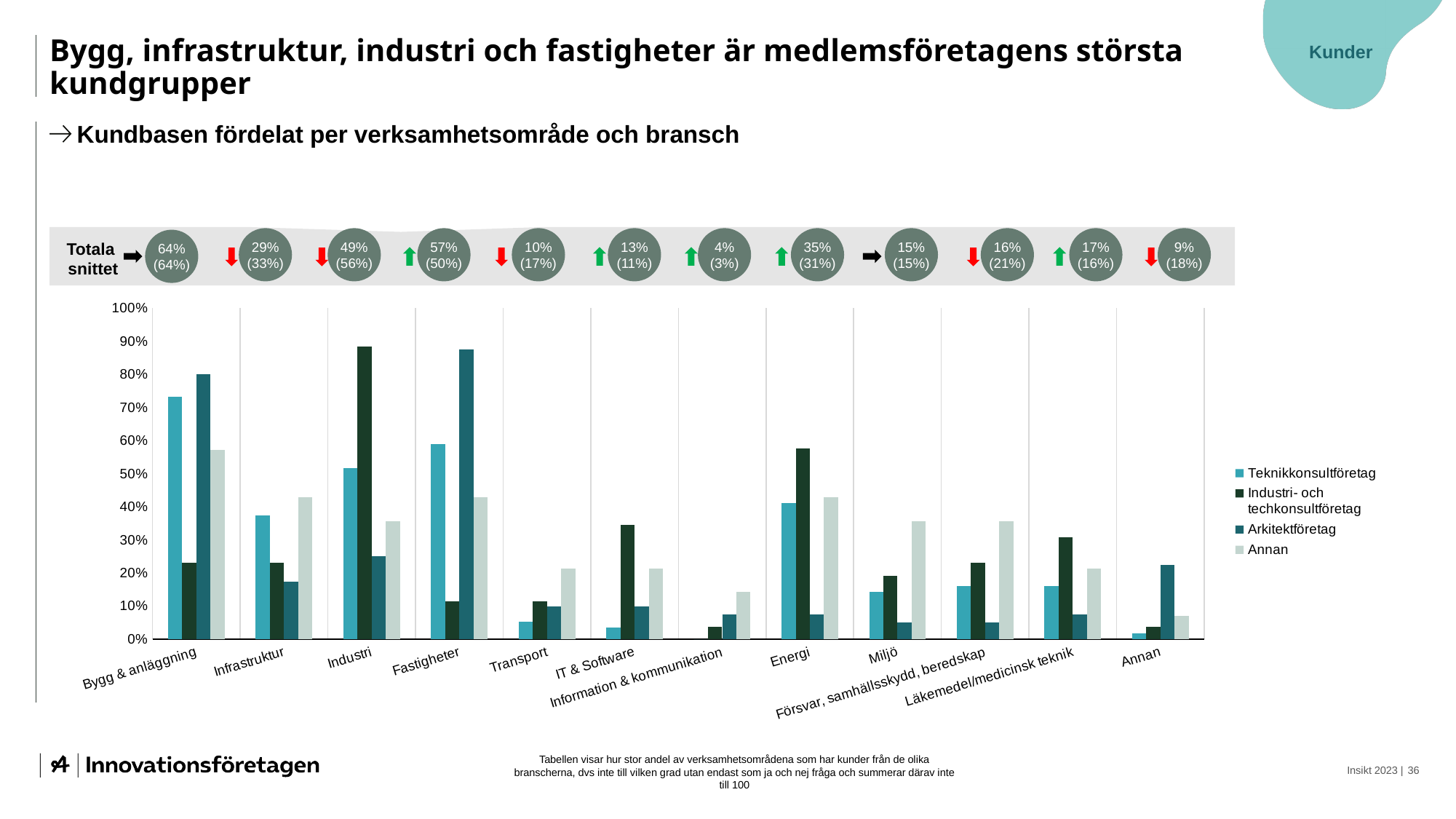
Is the Industri- och techkonsultföretag value for Energi greater or less than 50%? greater Which series has the lowest value for Annan? Teknikkonsultföretag What is the 'Totala snittet' value shown above the chart for Bygg & anläggning? 64% What kind of chart is shown on the slide? bar chart Is the Teknikkonsultföretag value for Transport greater or less than 10%? less Is the Industri- och techkonsultföretag value for Industri greater or less than 80%? greater How many series does the chart legend list? 4 For Teknikkonsultföretag, which is larger: the value for Bygg & anläggning or the value for Infrastruktur? Bygg & anläggning What is the 'Totala snittet' value shown above the chart for Information & kommunikation? 4% How many categories are shown along the x axis of the chart? 12 Which series has the highest value for Fastigheter? Arkitektföretag